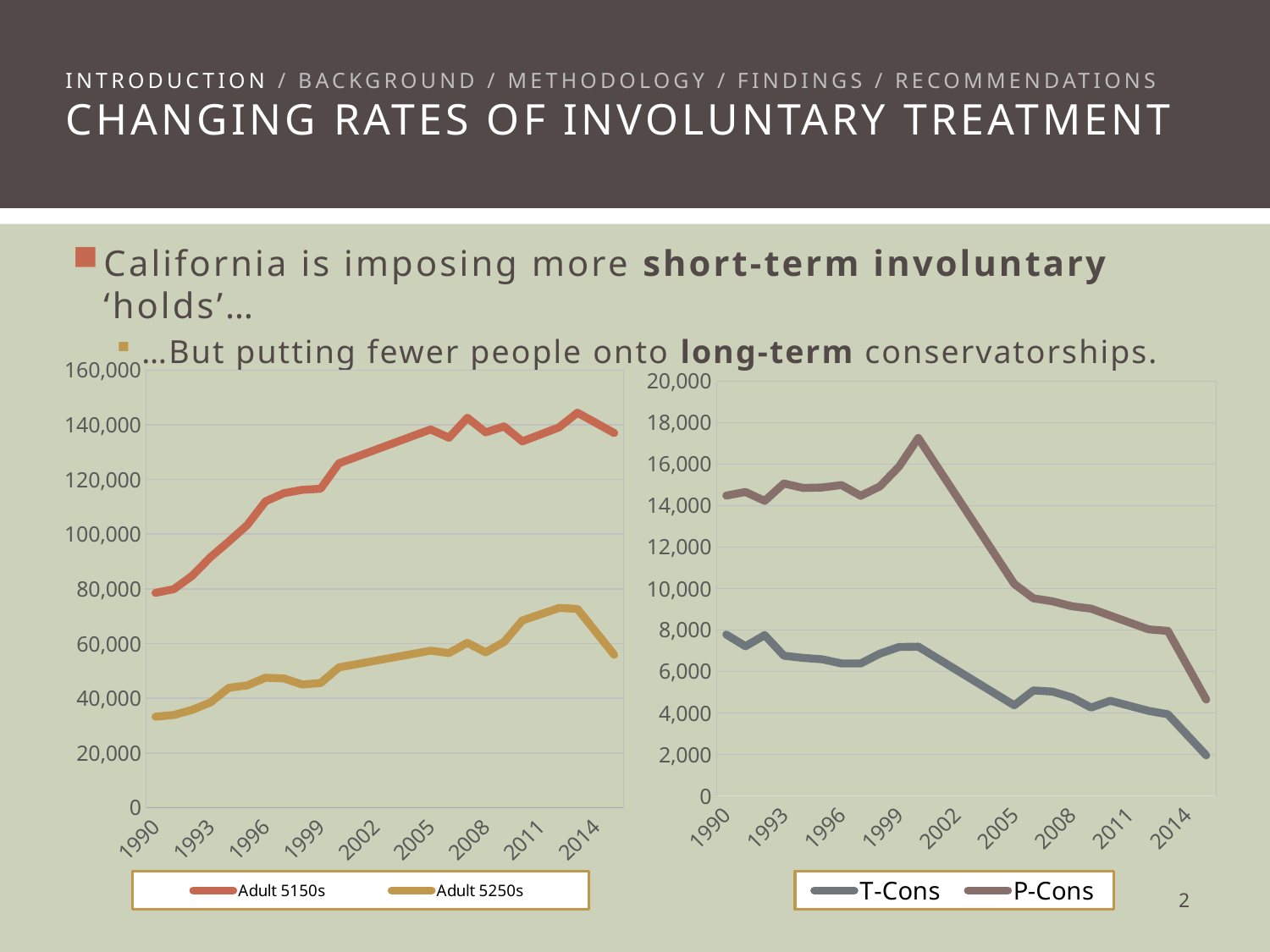
In the left chart, does the Adult 5150s line generally rise or fall from 1990 to 2014? rise In the left chart, is the value for Adult 5250s in 1990 greater or less than 40,000? less In the right chart, does the P-Cons line generally rise or fall from 2000 onward? fall In the right chart, which series has the larger value in 2000, T-Cons or P-Cons? P-Cons In the left chart, which series has the larger value in 2014, Adult 5150s or Adult 5250s? Adult 5150s In the right chart, is the value for T-Cons in 2005 greater or less than 6,000? less What kind of chart is the left chart (Adult 5150s / Adult 5250s)? line chart How many series does the legend of the left chart list? 2 What kind of chart is the right chart (T-Cons / P-Cons)? line chart In the right chart, is the value for P-Cons in 2000 greater or less than 16,000? greater How many series does the legend of the right chart list? 2